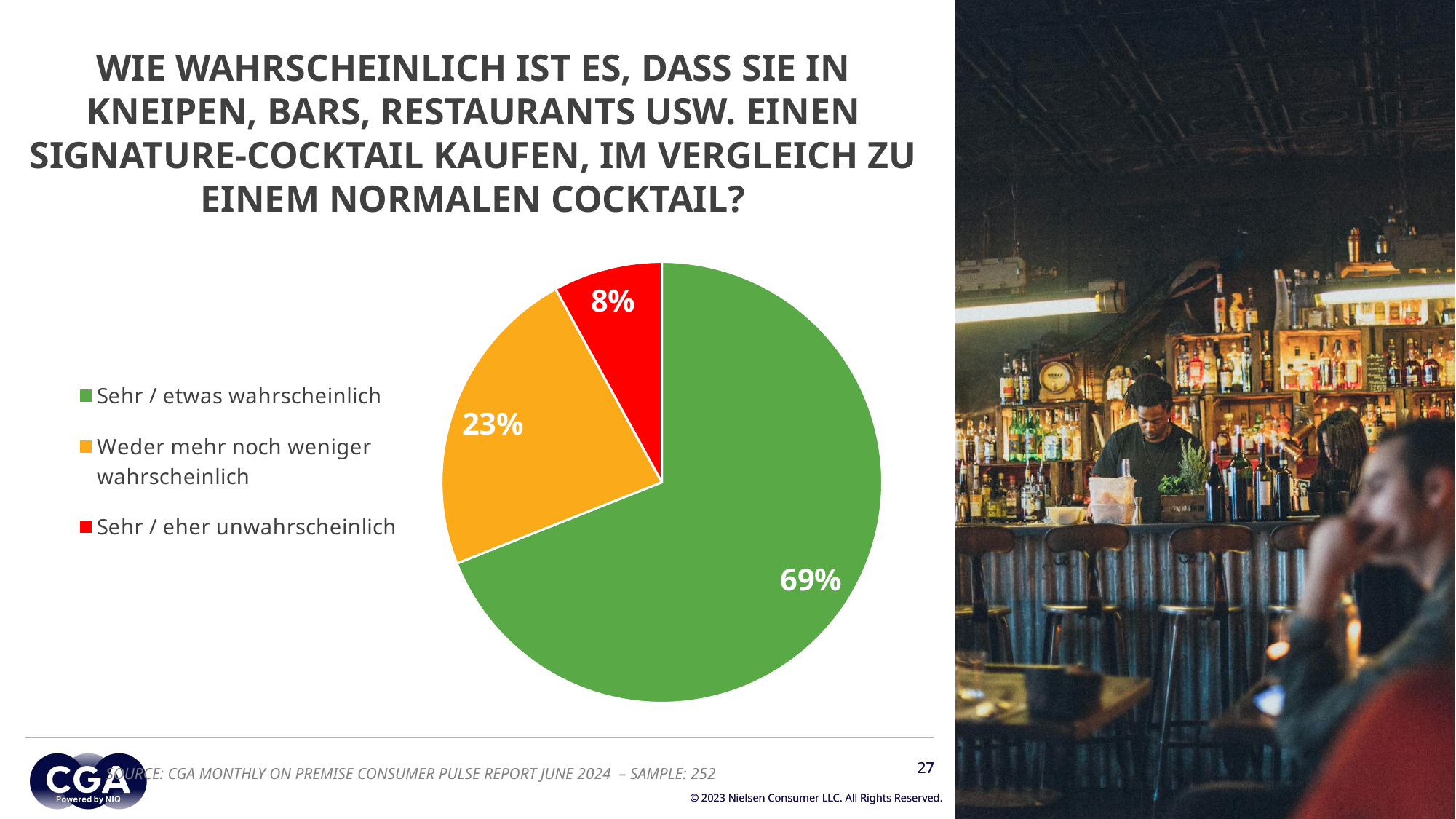
How many categories does the pie chart show? 3 What share of respondents answered "Sehr / etwas wahrscheinlich"? 69% What is the sample size stated in the source line below the chart? 252 What colour is the slice for "Sehr / eher unwahrscheinlich"? Red Which is larger: the share for "Weder mehr noch weniger wahrscheinlich" or for "Sehr / eher unwahrscheinlich"? Weder mehr noch weniger wahrscheinlich Which category has the largest slice of the pie? Sehr / etwas wahrscheinlich What is the difference in percentage points between "Sehr / etwas wahrscheinlich" and "Weder mehr noch weniger wahrscheinlich"? 46 percentage points Which category has the smallest slice of the pie? Sehr / eher unwahrscheinlich What share of respondents answered "Sehr / eher unwahrscheinlich"? 8% What kind of chart is shown on the slide? Pie chart What share of respondents answered "Weder mehr noch weniger wahrscheinlich"? 23% What is the difference in percentage points between "Weder mehr noch weniger wahrscheinlich" and "Sehr / eher unwahrscheinlich"? 15 percentage points